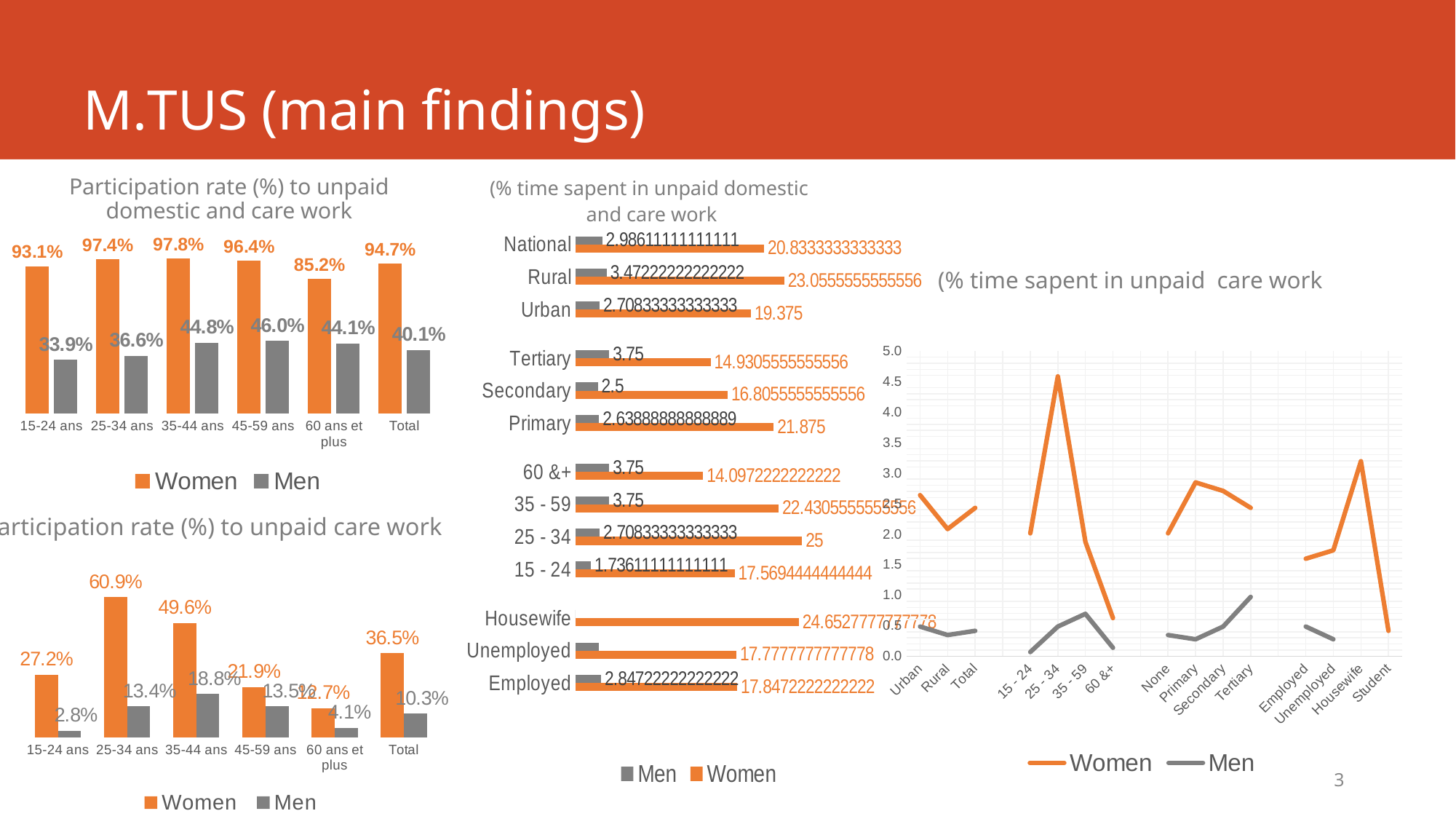
In the 'Participation rate (%) to unpaid care work' chart, what is the value for Women in the 25-34 ans category? 60.9% In the 'Participation rate (%) to unpaid domestic and care work' chart, what is the value for Men in the Total category? 40.1% In the '(% time sapent in unpaid domestic and care work' chart, what is the value for Men in the 15 - 24 category? 1.73611111111111 In the 'Participation rate (%) to unpaid care work' chart, what is the value for Men in the 15-24 ans category? 2.8% In the 'Participation rate (%) to unpaid domestic and care work' chart, which age category has the lowest value for Women? 60 ans et plus In the 'Participation rate (%) to unpaid care work' chart, which category has the highest value for Men? 35-44 ans What kind of chart is the '(% time sapent in unpaid care work' chart on the right of the slide? Line chart In the 'Participation rate (%) to unpaid domestic and care work' chart, what is the difference between the Women and Men values for 15-24 ans? 59.2% In the '(% time sapent in unpaid care work' line chart, is the value for Women at 25 - 34 greater or less than 4.0? greater In the '(% time sapent in unpaid domestic and care work' chart, what is the value for Women in the Rural category? 23.0555555555556 In the 'Participation rate (%) to unpaid domestic and care work' chart, what is the value for Women in the 35-44 ans category? 97.8% In the '(% time sapent in unpaid domestic and care work' chart, which is larger for Women: Primary or Tertiary? Primary